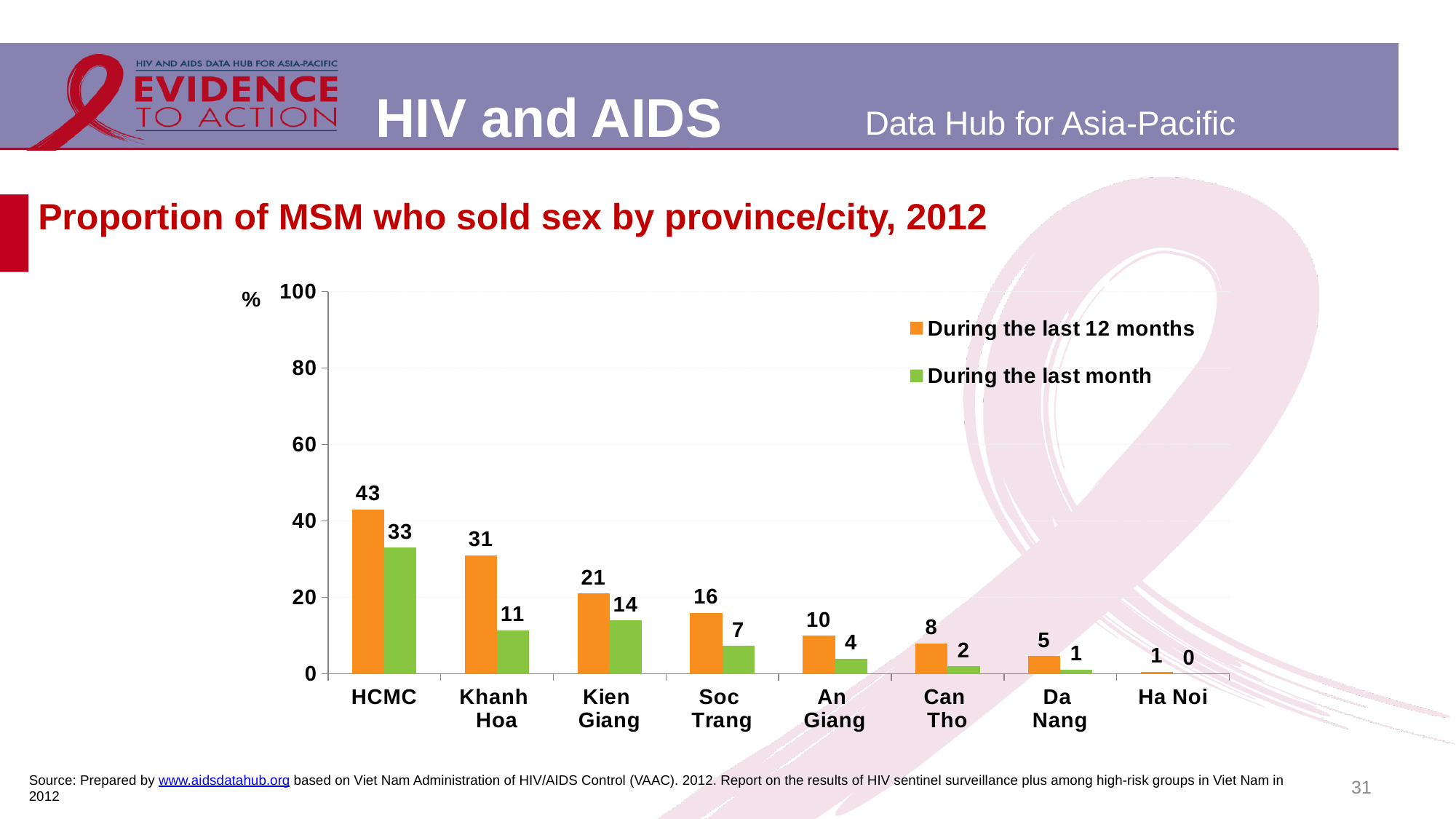
Which province/city has the lowest value in the 'During the last month' series? Ha Noi What is the value for Khanh Hoa in the 'During the last month' series? 11 What is the value for HCMC in the 'During the last 12 months' series? 43 Which province/city has the highest value in the 'During the last 12 months' series? HCMC What kind of chart is shown on the slide? bar chart What is the difference between the 'During the last 12 months' and 'During the last month' values for Khanh Hoa? 20 Is the 'During the last 12 months' value for HCMC greater or less than 40? greater Do the 'During the last 12 months' values rise or fall from HCMC to Ha Noi along the x axis? fall How many provinces/cities are shown on the x axis? 8 How many series does the legend list? 2 Which is larger: the 'During the last month' value for Kien Giang or for Soc Trang? Kien Giang What is the value for Soc Trang in the 'During the last 12 months' series? 16